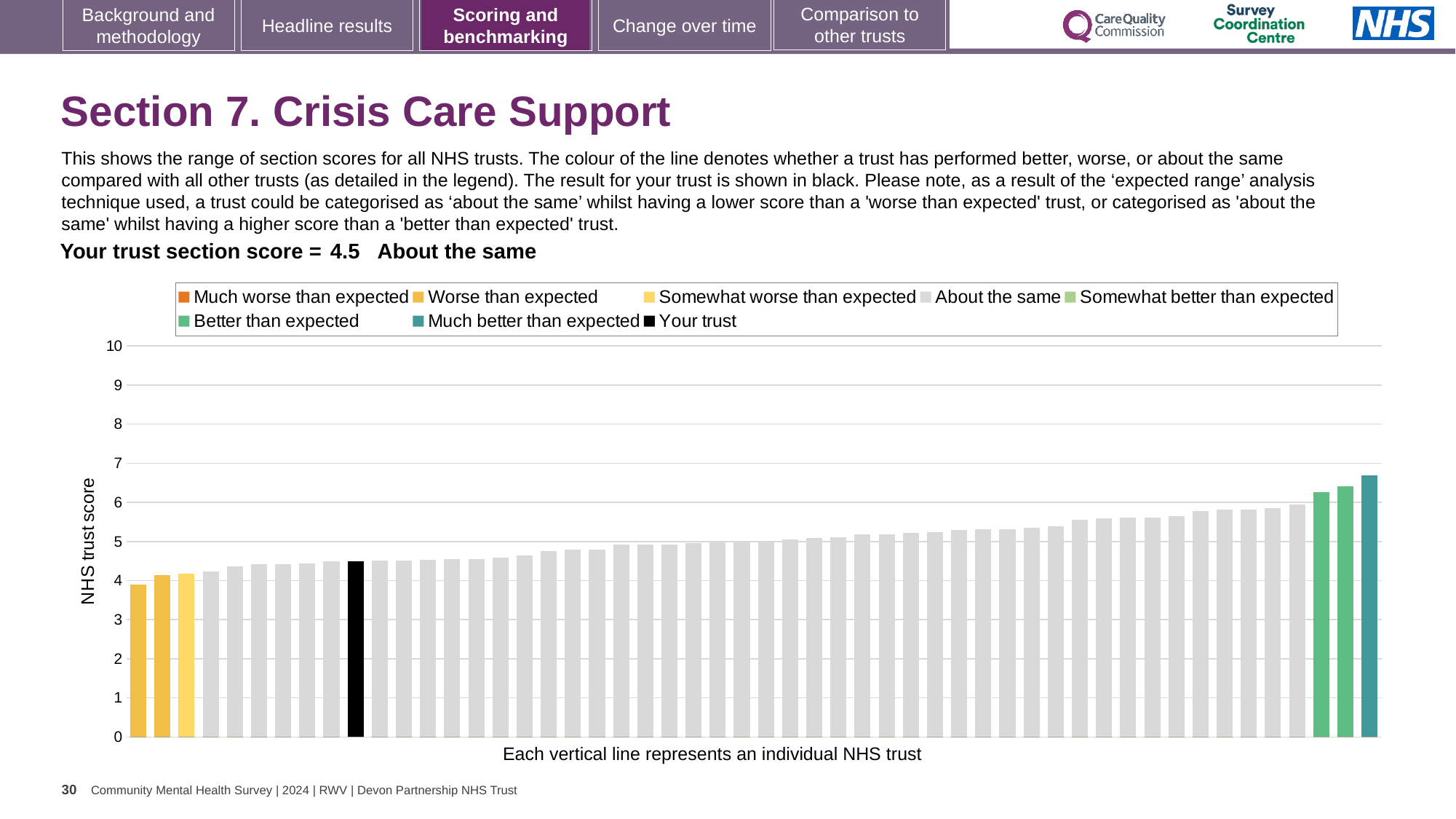
Do the bar values rise or fall from left to right across the chart? Rise Is the value of the tallest bar on the chart greater or less than 7? less What is the label on the vertical axis of the chart? NHS trust score Is the value of the tallest bar on the chart greater or less than 6? greater How many bars on the chart are coloured as 'Much worse than expected'? 0 Which legend category does the tallest bar on the chart belong to? Much better than expected How many entries does the chart's legend list? 8 What is the section score for your trust shown on the chart? 4.5 How many bars on the chart are coloured as 'Better than expected'? 2 Which category is your trust placed in according to the slide? About the same What kind of chart is shown on the slide? Bar chart Is the score for your trust (the black bar) greater or less than 5? less